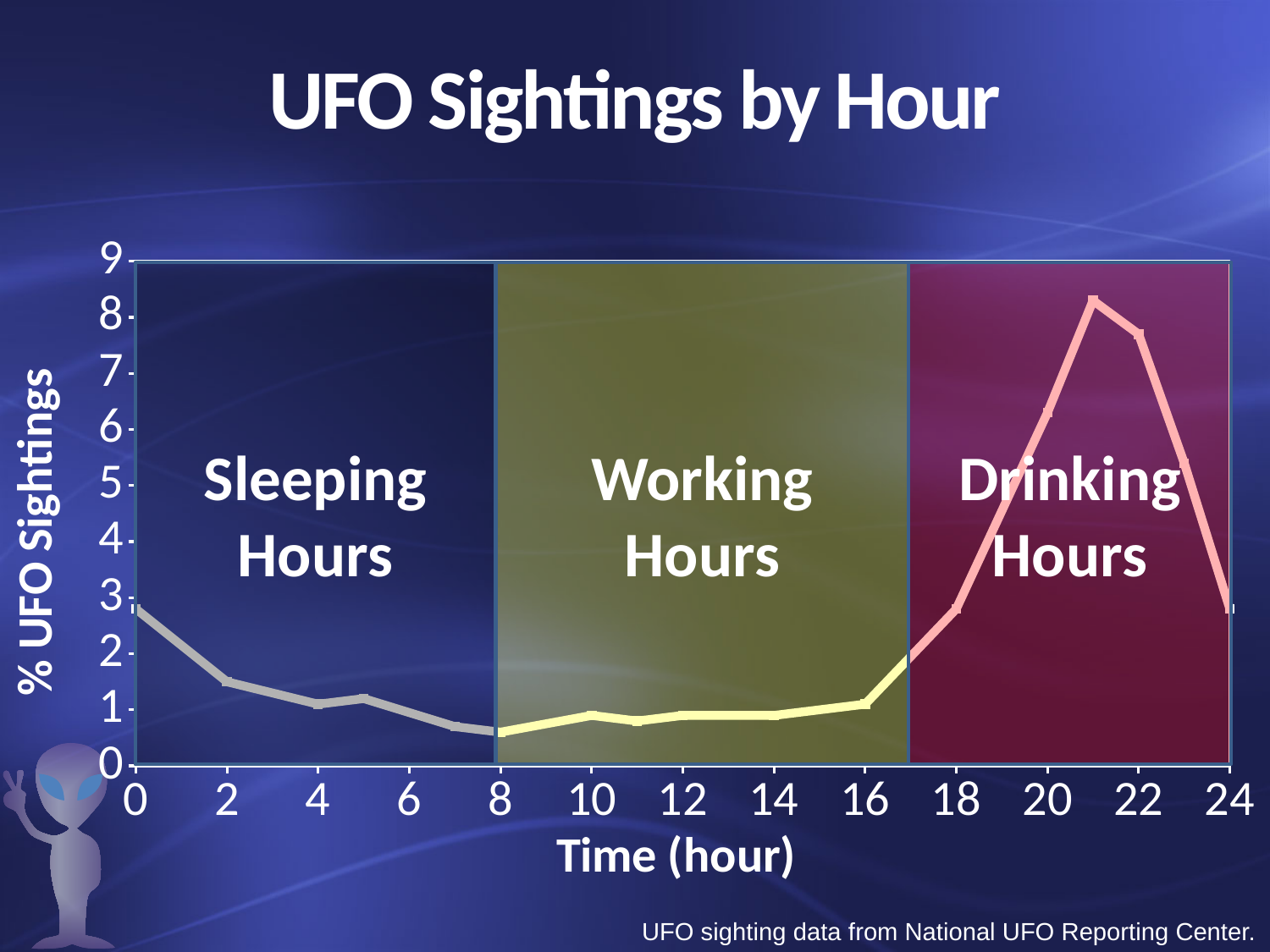
Is the value at hour 0 greater or less than 2? greater Which has a higher percentage of UFO sightings, hour 22 or hour 12? hour 22 At which hour is the percentage of UFO sightings highest? 21 What kind of chart is shown on the slide? line chart Do the values rise or fall from hour 0 to hour 8? fall Which has a higher percentage of UFO sightings, hour 2 or hour 8? hour 2 What is the title of the chart? UFO Sightings by Hour What are the three labelled regions on the chart? Sleeping Hours, Working Hours, Drinking Hours Is the value at hour 18 greater or less than 2? greater Is the value at hour 21 greater or less than 7? greater Do the values rise or fall from hour 17 to hour 21? rise